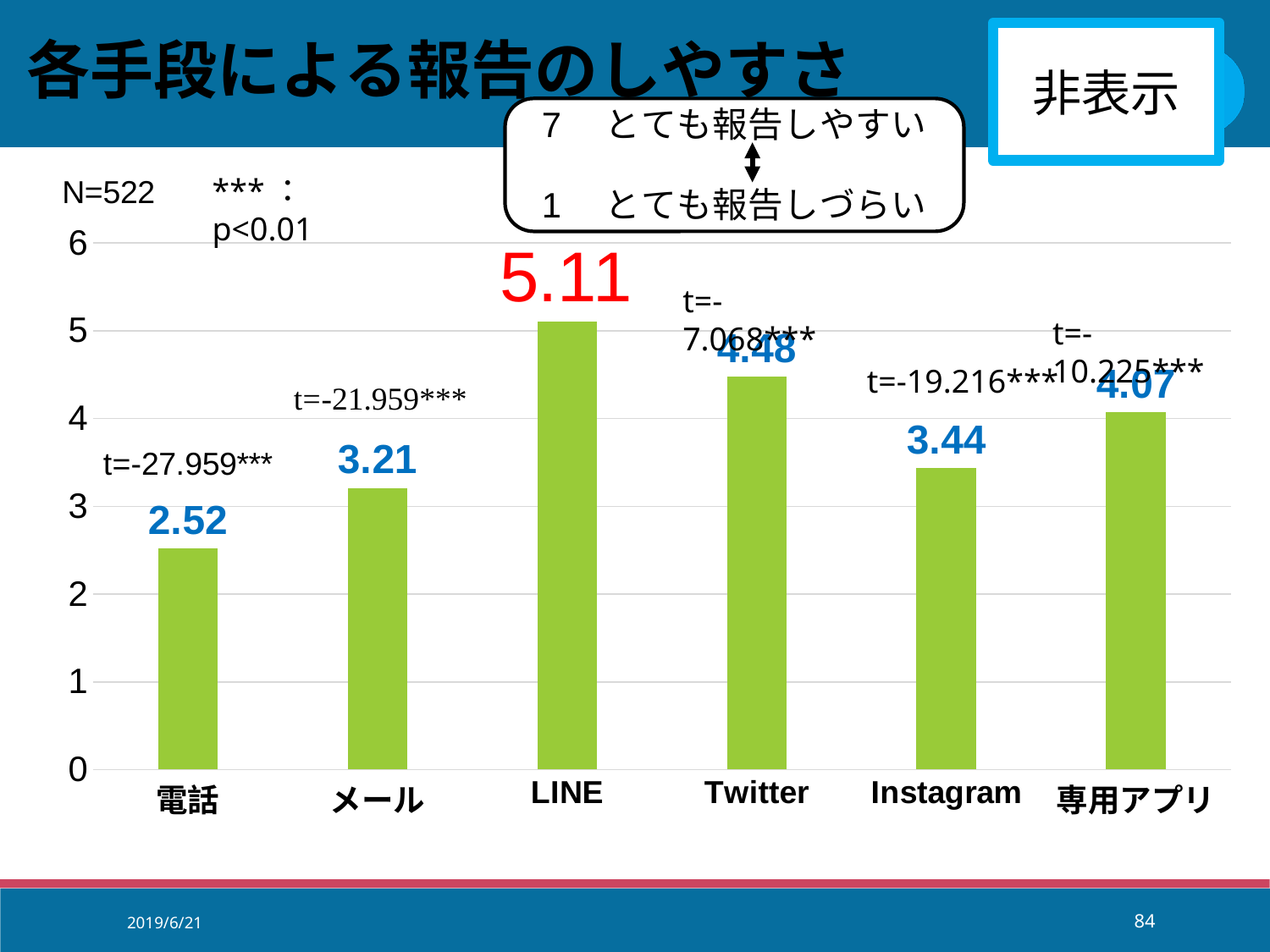
Which is larger, the value for メール or the value for Instagram? Instagram What is the difference between the values for LINE and 電話? 2.59 How many categories are shown in the chart? 6 What is the difference between the values for Twitter and 専用アプリ? 0.41 What is the value for LINE? 5.11 What is the title of the chart? 各手段による報告のしやすさ Which category has the lowest value? 電話 What is the value for Instagram? 3.44 What is the value for 電話? 2.52 What is the value for 専用アプリ? 4.07 Which category has the highest value? LINE What kind of chart is shown on the slide? Bar chart